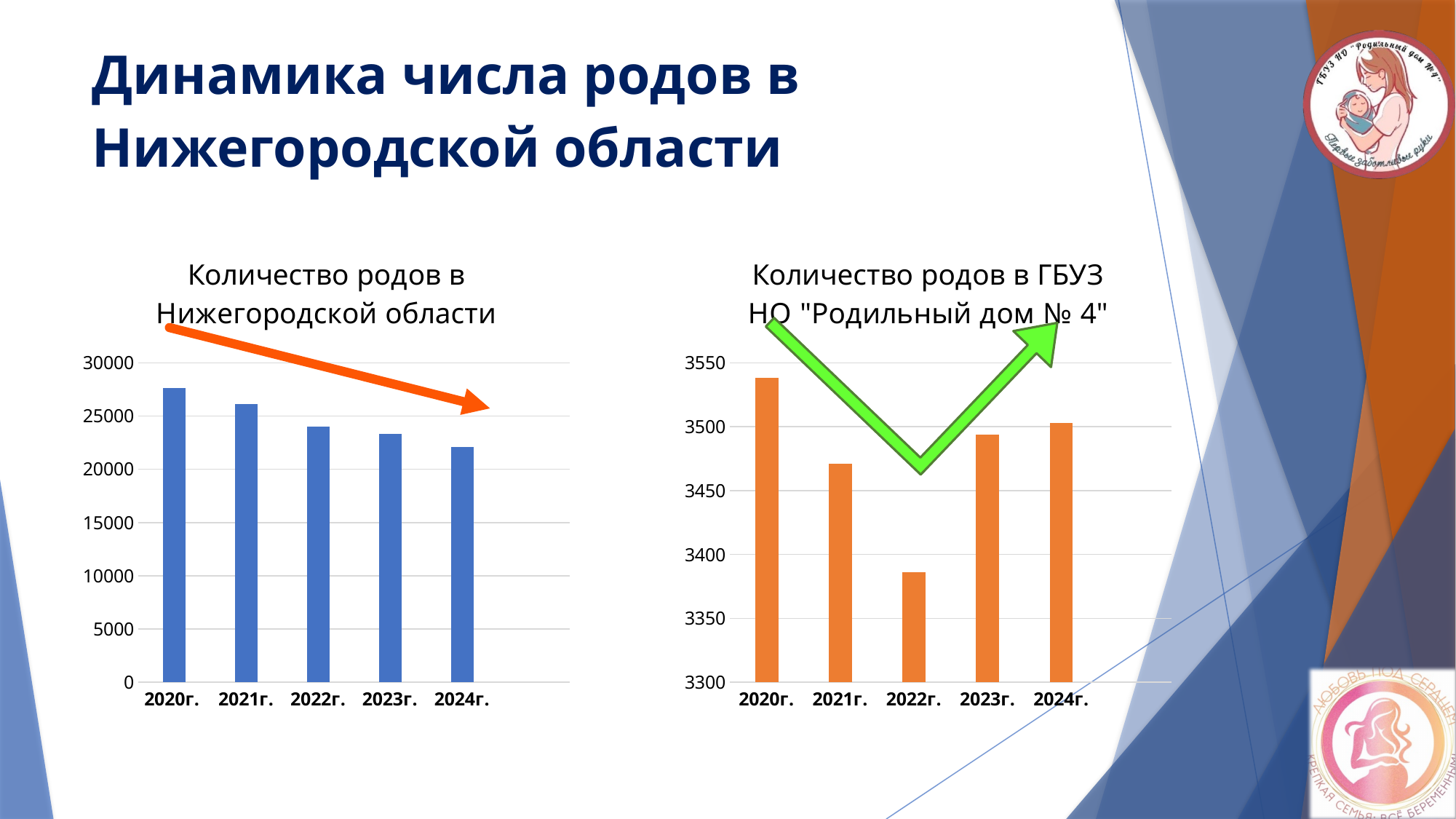
In the left chart, "Количество родов в Нижегородской области", which year has the lowest value? 2024г. In the right chart, "Количество родов в ГБУЗ НО "Родильный дом № 4"", which year has the highest value? 2020г. In the right chart, "Количество родов в ГБУЗ НО "Родильный дом № 4"", is the value for 2022г. greater or less than 3400? less What kind of chart is the left chart, "Количество родов в Нижегородской области"? bar chart In the right chart, "Количество родов в ГБУЗ НО "Родильный дом № 4"", which year has the lowest value? 2022г. In the right chart, "Количество родов в ГБУЗ НО "Родильный дом № 4"", which is larger, the value for 2020г. or the value for 2021г.? 2020г. In the left chart, "Количество родов в Нижегородской области", is the value for 2020г. greater or less than 25000? greater What colour are the bars in the right chart, "Количество родов в ГБУЗ НО "Родильный дом № 4""? orange In the left chart, "Количество родов в Нижегородской области", which year has the highest value? 2020г. In the left chart, "Количество родов в Нижегородской области", do the values rise or fall from 2020г. to 2024г.? fall How many years are shown on the x axis of the right chart, "Количество родов в ГБУЗ НО "Родильный дом № 4""? 5 In the left chart, "Количество родов в Нижегородской области", is the value for 2024г. greater or less than 25000? less